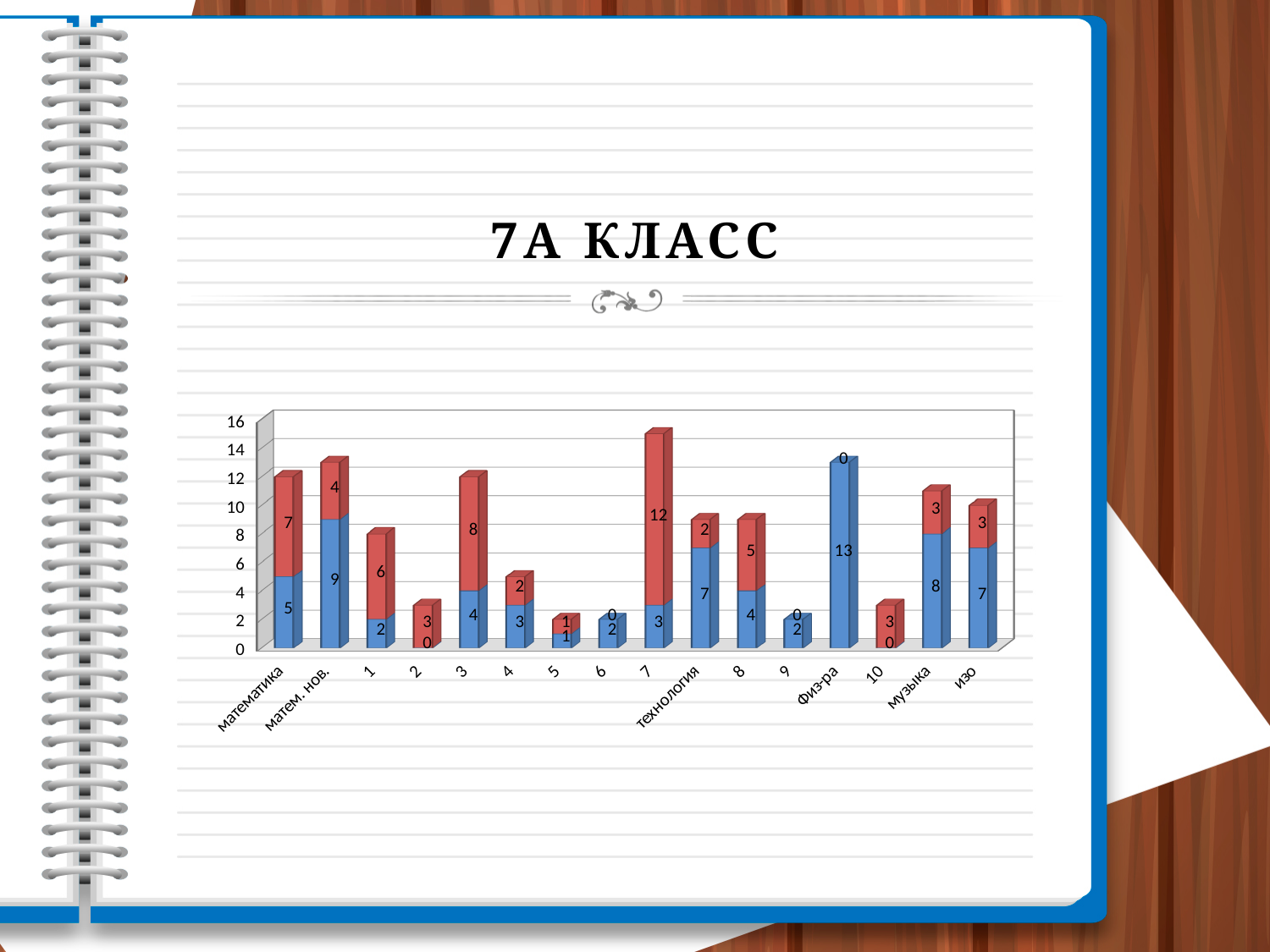
What is the value of the blue segment for "Физ-ра"? 13 What is the value of the red segment for "технология"? 2 How many categories are shown along the x axis of the chart? 16 What is the total of the stacked bar for "матем. нов."? 13 What is the difference between the red segment for "3" and the red segment for "4"? 6 What is the value of the blue segment for "математика"? 5 Which is larger: the blue segment for "музыка" or the blue segment for "изо"? музыка What kind of chart is shown on the slide? stacked bar chart What is the value of the red segment for "7"? 12 What is the total of the stacked bar for "7"? 15 Which category has the tallest stacked bar? 7 What is the title of the slide above the chart? 7А КЛАСС